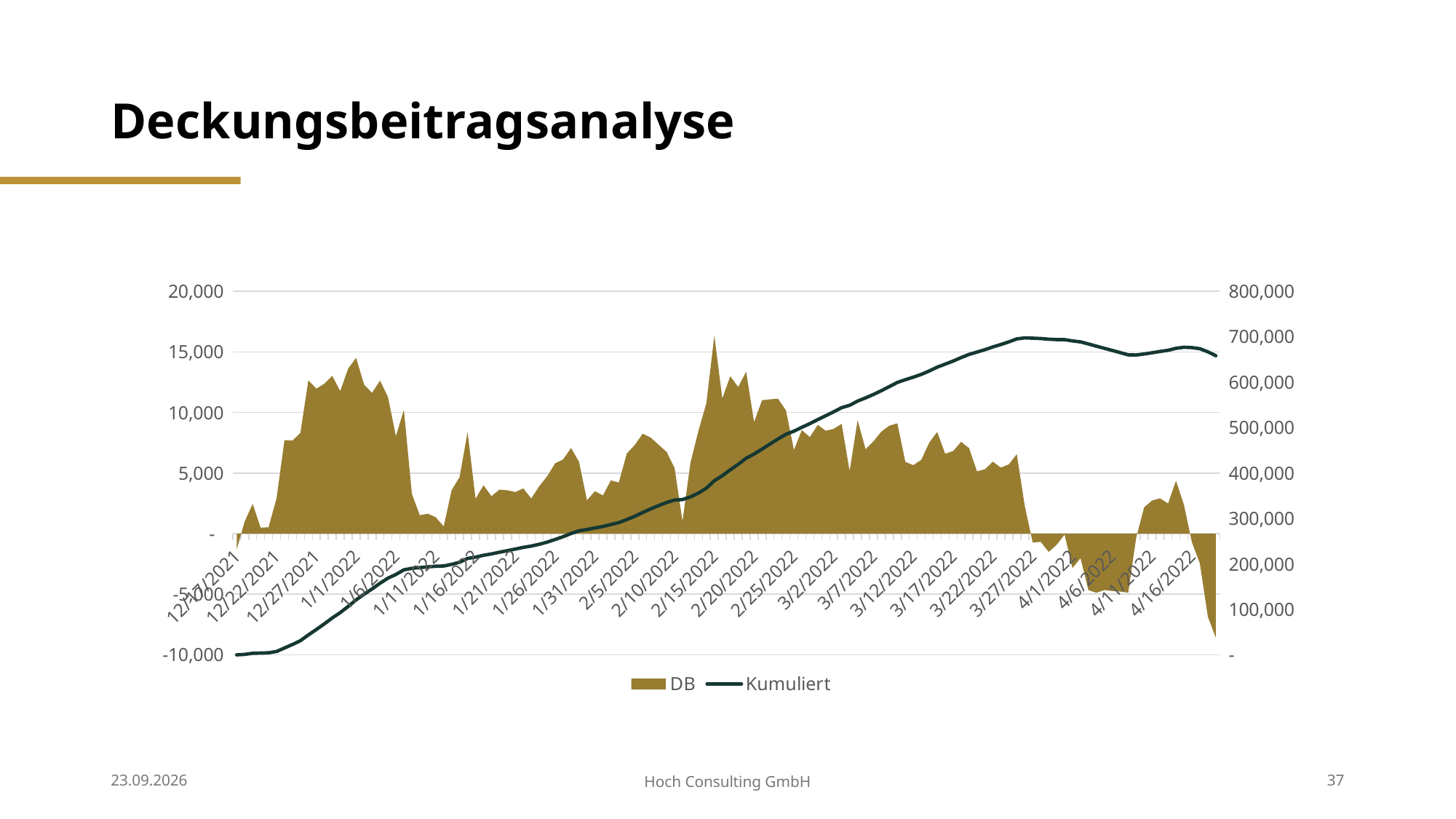
Does the Kumuliert line rise or fall between 12/17/2021 and 3/27/2022? Rises Which is larger, the Kumuliert value at 1/1/2022 or at 3/2/2022? 3/2/2022 Is the DB value at 4/6/2022 greater or less than 0? less What are the two series named in the legend? DB and Kumuliert What is the title of the chart on the slide? Deckungsbeitragsanalyse Is the Kumuliert value at 4/16/2022 greater or less than 600,000 on the right axis? greater Is the Kumuliert value at 12/17/2021 greater or less than 100,000 on the right axis? less What kind of chart is shown on the slide? A combination of an area chart (DB) and a line chart (Kumuliert) What is the highest value shown on the right-hand axis? 800,000 How many series does the chart legend list? 2